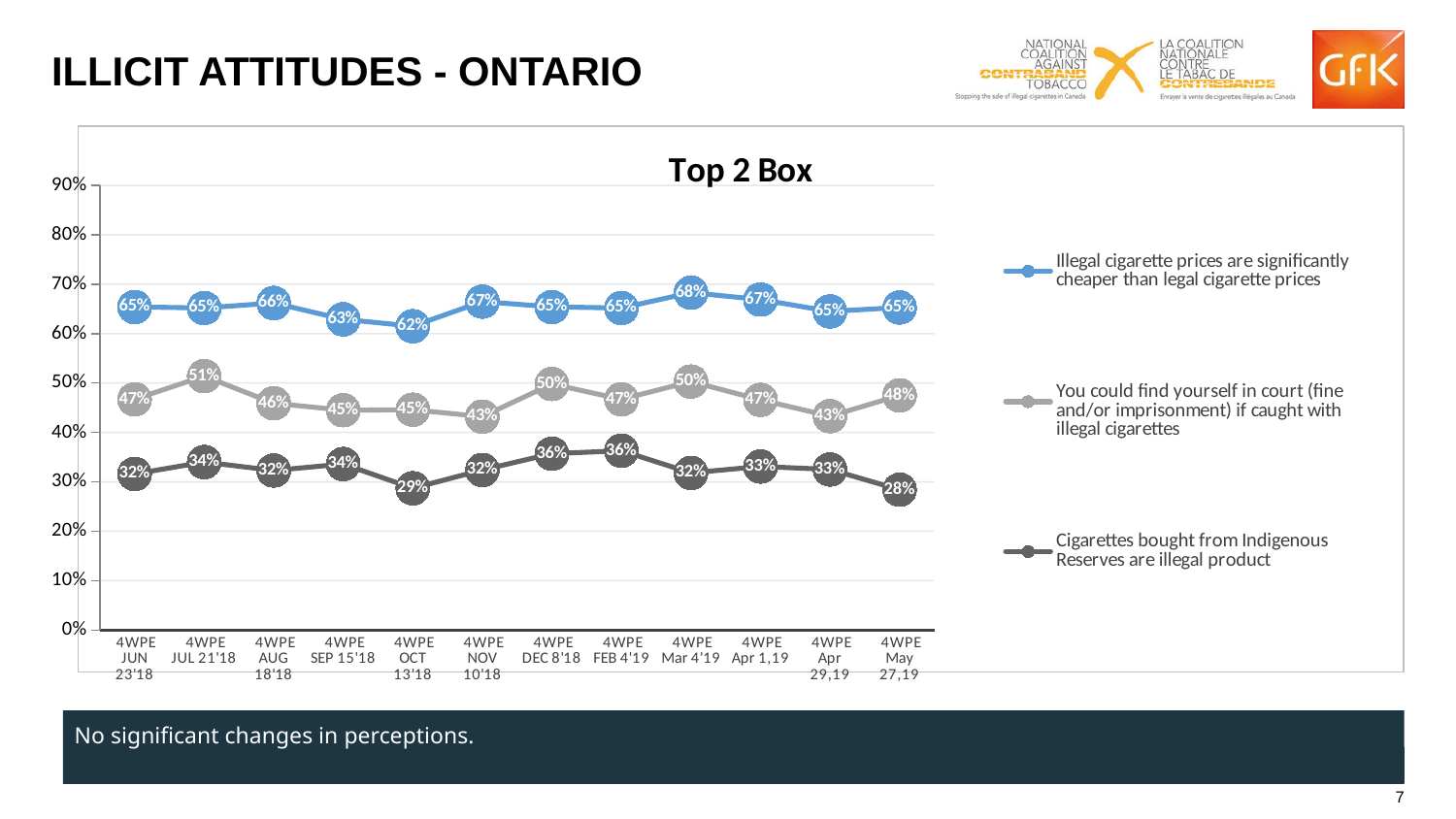
What is the value for "Cigarettes bought from Indigenous Reserves are illegal product" at 4WPE OCT 13'18? 29% How many series does the legend list? 3 What is the value for "Illegal cigarette prices are significantly cheaper than legal cigarette prices" at 4WPE Mar 4'19? 68% Which series has the higher value at 4WPE DEC 8'18: "You could find yourself in court (fine and/or imprisonment) if caught with illegal cigarettes" or "Cigarettes bought from Indigenous Reserves are illegal product"? You could find yourself in court (fine and/or imprisonment) if caught with illegal cigarettes What kind of chart is shown under the title "Top 2 Box"? Line chart What is the value for "You could find yourself in court (fine and/or imprisonment) if caught with illegal cigarettes" at 4WPE JUL 21'18? 51% Is the value for "You could find yourself in court (fine and/or imprisonment) if caught with illegal cigarettes" at 4WPE NOV 10'18 greater or less than 50%? less At which period is the value for "Illegal cigarette prices are significantly cheaper than legal cigarette prices" lowest? 4WPE OCT 13'18 At which period is the value for "Cigarettes bought from Indigenous Reserves are illegal product" lowest? 4WPE May 27,19 What colour is the line for "Illegal cigarette prices are significantly cheaper than legal cigarette prices"? Blue What is the difference between the "Illegal cigarette prices are significantly cheaper than legal cigarette prices" value and the "Cigarettes bought from Indigenous Reserves are illegal product" value at 4WPE JUN 23'18? 33 percentage points How many time periods are plotted along the x axis? 12